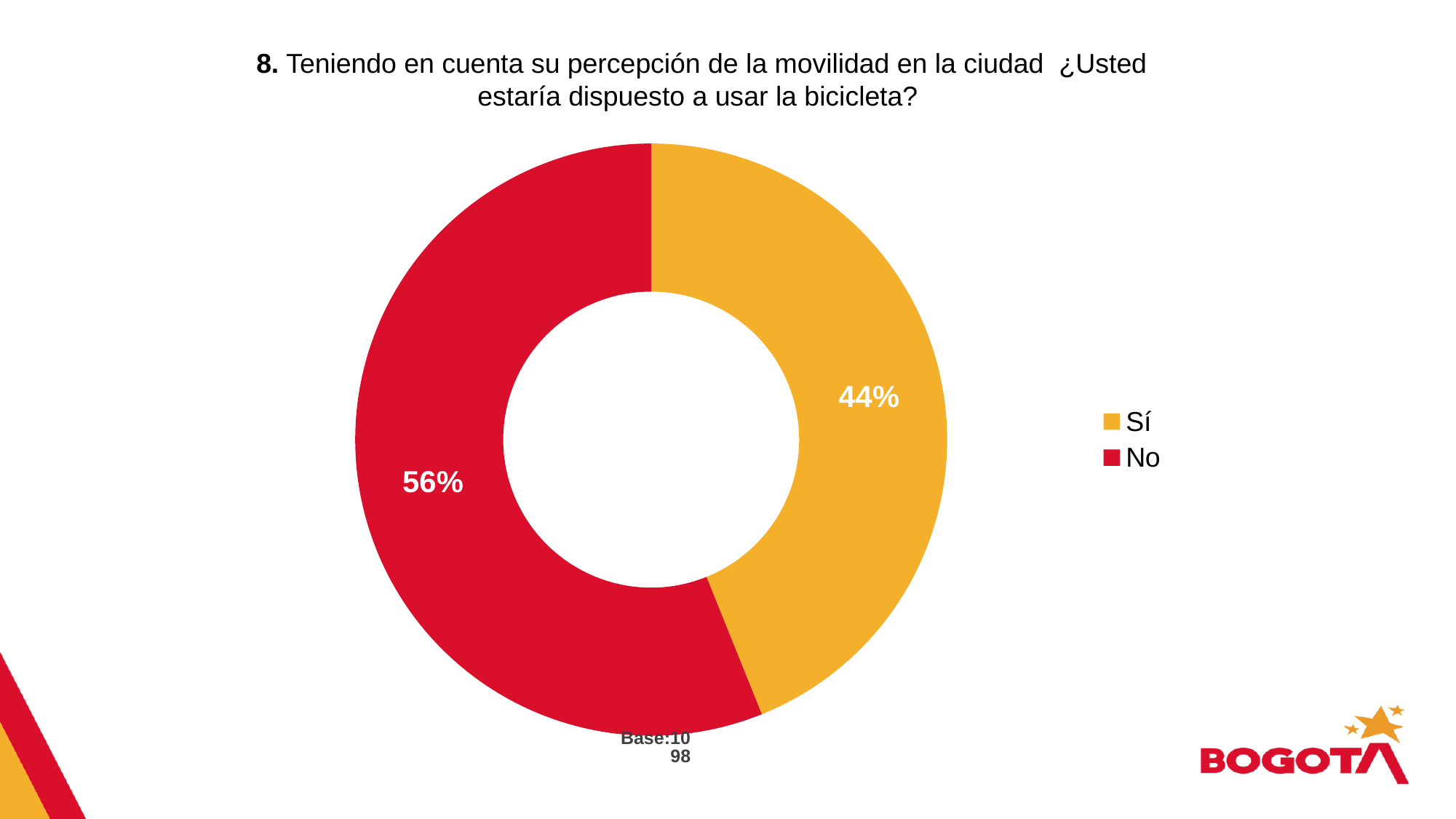
Is the share for "Sí" larger or smaller than the share for "No"? smaller Which response has the smaller share? Sí What percentage of respondents answered "Sí"? 44% What kind of chart is shown on the slide? Doughnut (pie) chart How many entries does the legend list? 2 How many categories are shown in the chart? 2 Which colour represents the "Sí" response in the chart? Yellow/orange What share of the chart does the "No" slice represent? 56% Which response has the larger share, "Sí" or "No"? No What is the base (number of respondents) noted below the chart? 1098 What is the difference in percentage points between the "No" and "Sí" shares? 12 What percentage of respondents answered "No"? 56%